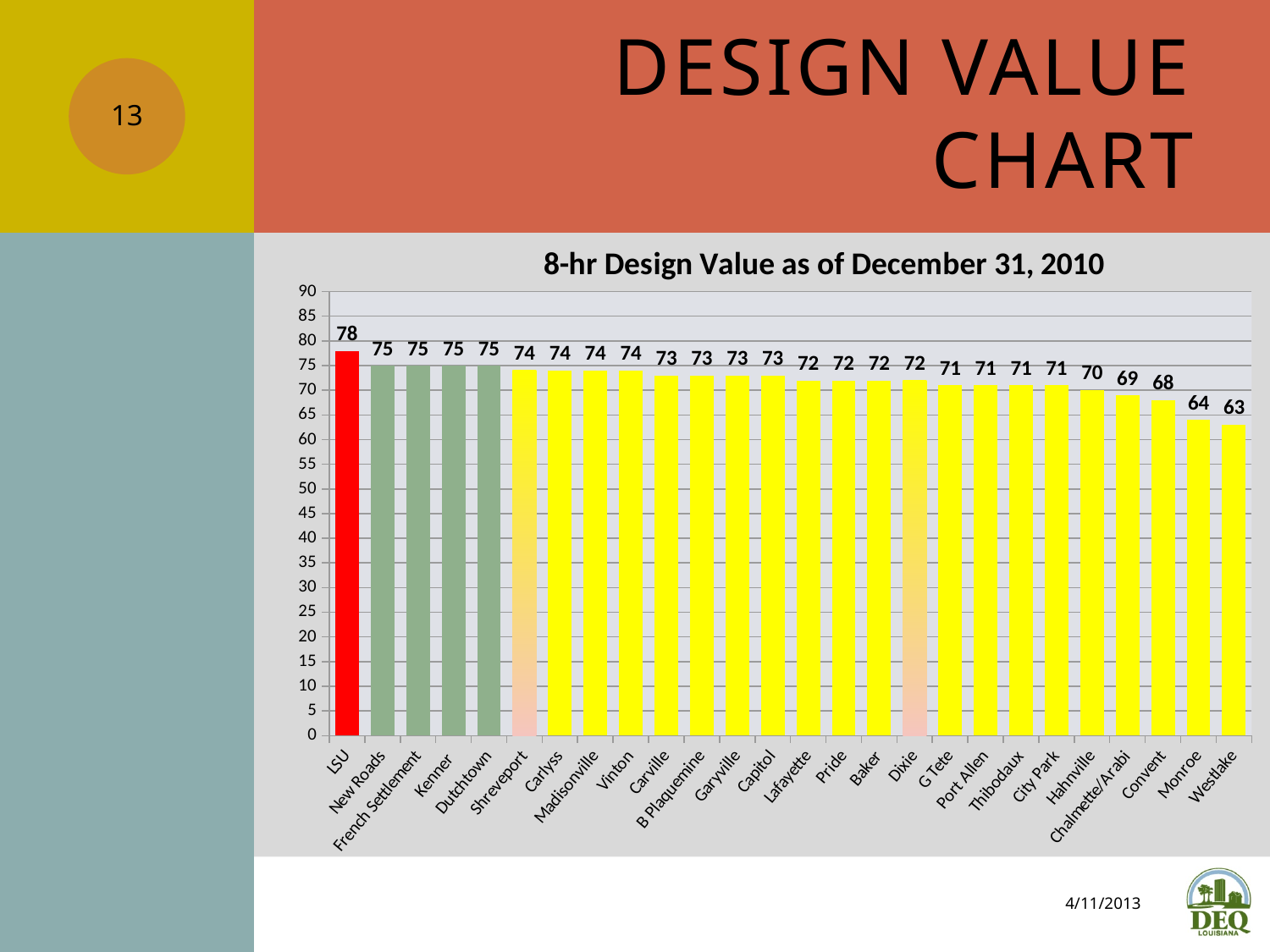
What is the difference between the design values for LSU and Westlake? 15 Which site has the lowest 8-hr design value? Westlake What kind of chart is shown on the slide? Bar chart What is the 8-hr design value for Hahnville? 70 Which site has the highest 8-hr design value? LSU What is the 8-hr design value for Monroe? 64 What is the difference between the design values for Kenner and Convent? 7 What is the 8-hr design value for LSU? 78 Which has a higher design value, Chalmette/Arabi or Monroe? Chalmette/Arabi How many sites are shown on the chart? 26 What is the title of the chart? 8-hr Design Value as of December 31, 2010 What is the 8-hr design value for Westlake? 63